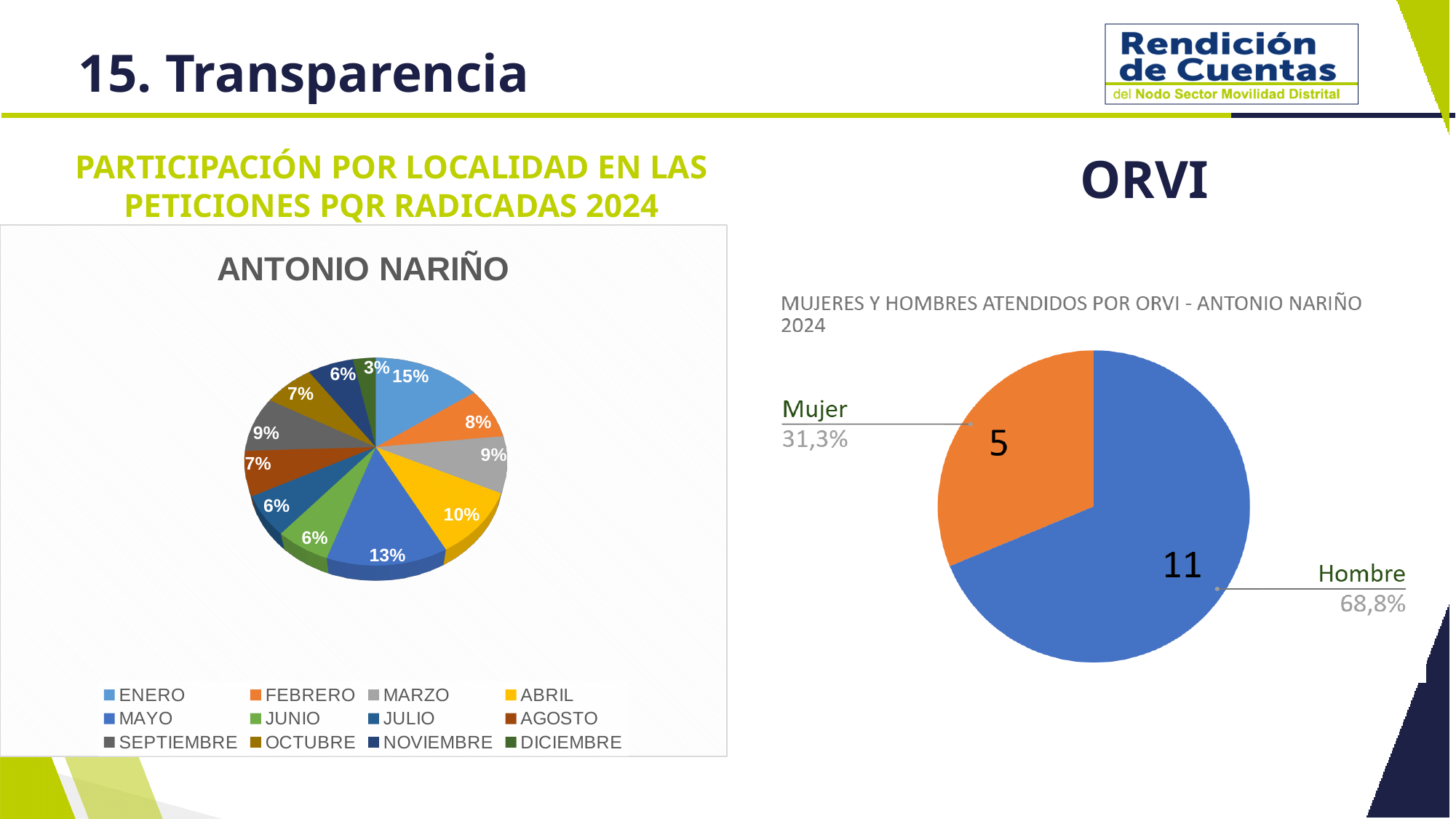
In the ANTONIO NARIÑO pie chart, what is the difference between the shares of ENERO and FEBRERO? 7% What kind of chart is the ANTONIO NARIÑO chart? Pie chart In the MUJERES Y HOMBRES ATENDIDOS POR ORVI chart, what is the difference between the Hombre and Mujer values? 6 In the ANTONIO NARIÑO pie chart, what share does MAYO have? 13% In the MUJERES Y HOMBRES ATENDIDOS POR ORVI chart, what is the value for Hombre? 11 In the ANTONIO NARIÑO pie chart, which month has the smallest share? DICIEMBRE In the ANTONIO NARIÑO pie chart, which month has the largest share? ENERO In the ANTONIO NARIÑO pie chart, what share does ENERO have? 15% In the ANTONIO NARIÑO pie chart, which has a larger share, ABRIL or MARZO? ABRIL In the MUJERES Y HOMBRES ATENDIDOS POR ORVI chart, what colour is the Mujer slice? Orange How many categories does the legend of the ANTONIO NARIÑO pie chart list? 12 In the MUJERES Y HOMBRES ATENDIDOS POR ORVI chart, what percentage share does Mujer have? 31,3%